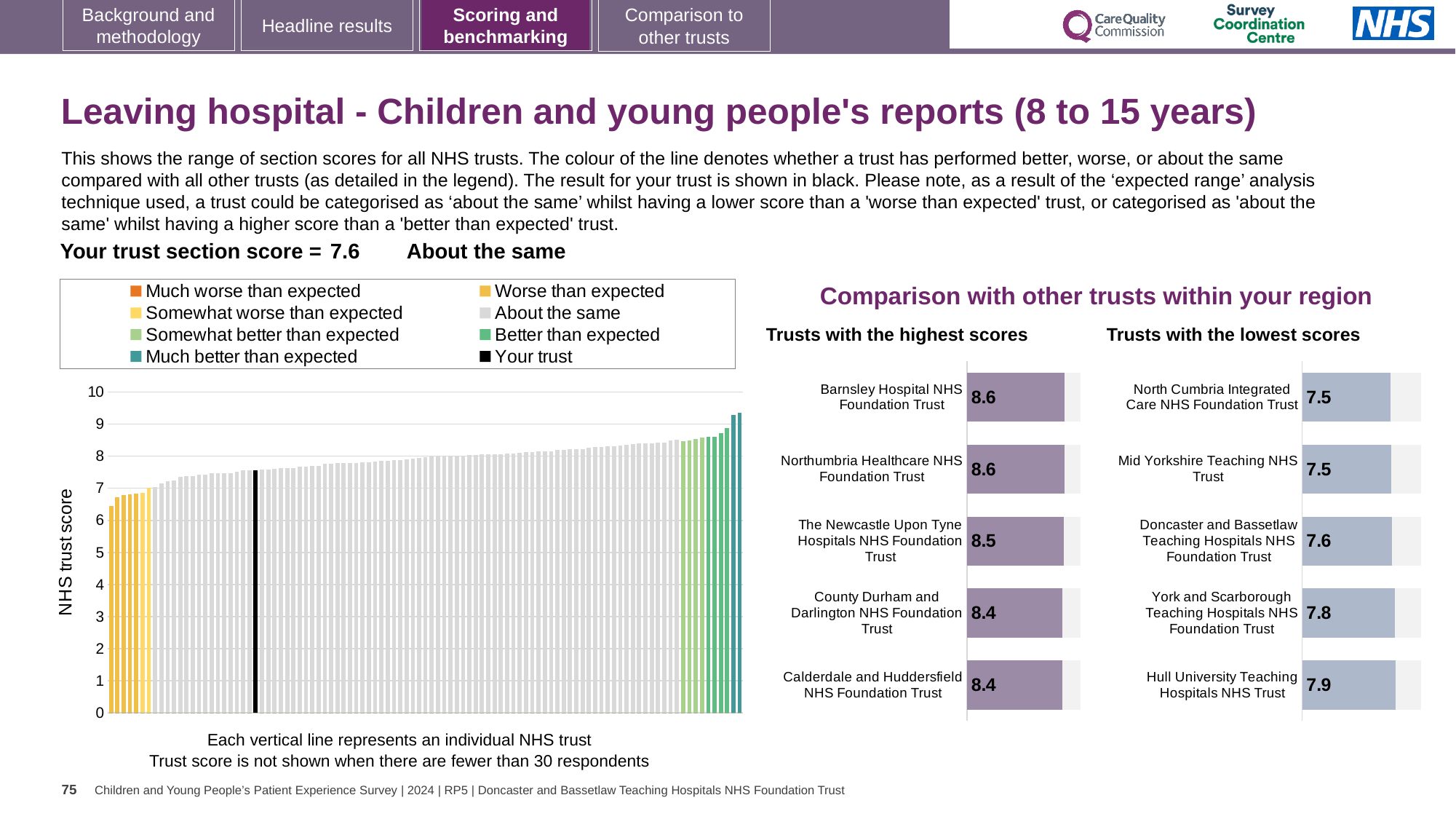
In the 'Trusts with the highest scores' chart, what is the score for Barnsley Hospital NHS Foundation Trust? 8.6 In the 'Trusts with the lowest scores' chart, which trust has the highest score? Hull University Teaching Hospitals NHS Trust What kind of chart is the large chart on the left with the 'NHS trust score' axis? Bar chart How many trusts are shown in the 'Trusts with the highest scores' chart? 5 In the 'Trusts with the lowest scores' chart, what is the score for Hull University Teaching Hospitals NHS Trust? 7.9 In the 'Trusts with the lowest scores' chart, which has the larger score: York and Scarborough Teaching Hospitals NHS Foundation Trust or Doncaster and Bassetlaw Teaching Hospitals NHS Foundation Trust? York and Scarborough Teaching Hospitals NHS Foundation Trust In the 'Trusts with the lowest scores' chart, what is the difference between the scores of Hull University Teaching Hospitals NHS Trust and North Cumbria Integrated Care NHS Foundation Trust? 0.4 In the 'Trusts with the highest scores' chart, what is the score for The Newcastle Upon Tyne Hospitals NHS Foundation Trust? 8.5 In the 'Trusts with the highest scores' chart, what is the difference between the scores of Barnsley Hospital NHS Foundation Trust and Calderdale and Huddersfield NHS Foundation Trust? 0.2 In the large 'NHS trust score' chart on the left, do the bar values rise or fall from left to right? Rise In the large 'NHS trust score' chart on the left, is the value of the black 'Your trust' bar greater or less than 7? greater How many entries does the legend of the large 'NHS trust score' chart on the left list? 8